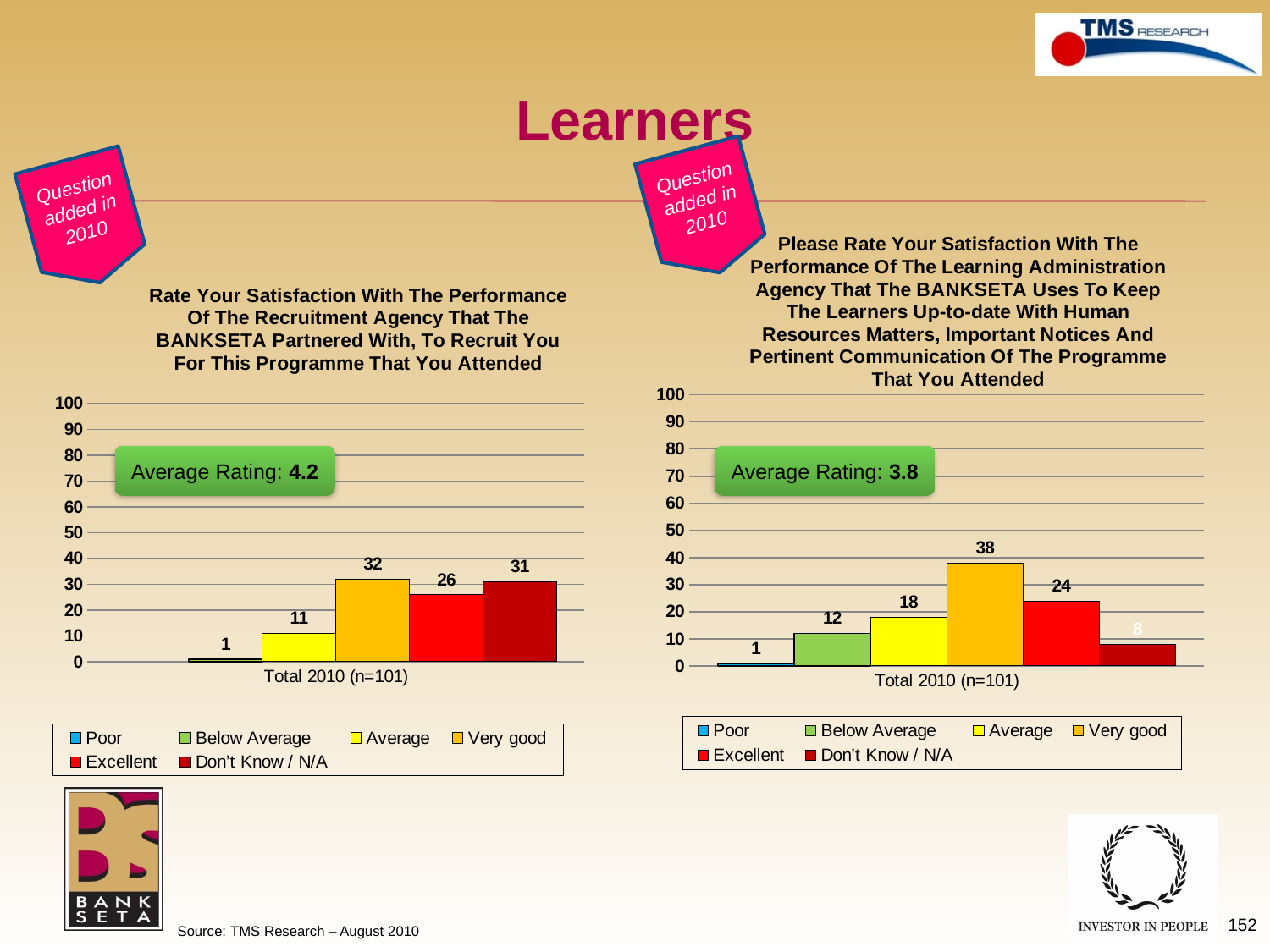
In the right chart (Learning Administration Agency satisfaction), what is the value for Very good? 38 In the right chart (Learning Administration Agency satisfaction), what is the difference between the Very good and Excellent values? 14 What average rating is shown on the right chart (Learning Administration Agency satisfaction)? 3.8 How many series does the legend of the left chart list? 6 In the left chart (Recruitment Agency satisfaction), which rating category has the highest value? Very good In the right chart (Learning Administration Agency satisfaction), what is the value for Excellent? 24 In the right chart (Learning Administration Agency satisfaction), which is larger, Average or Don't Know / N/A? Average In the left chart (Recruitment Agency satisfaction), what is the value for Very good? 32 In the left chart (Recruitment Agency satisfaction), what is the value for Average? 11 In the left chart (Recruitment Agency satisfaction), what is the value for Excellent? 26 In the left chart (Recruitment Agency satisfaction), what is the value for Don't Know / N/A? 31 In the right chart (Learning Administration Agency satisfaction), what is the value for Below Average? 12